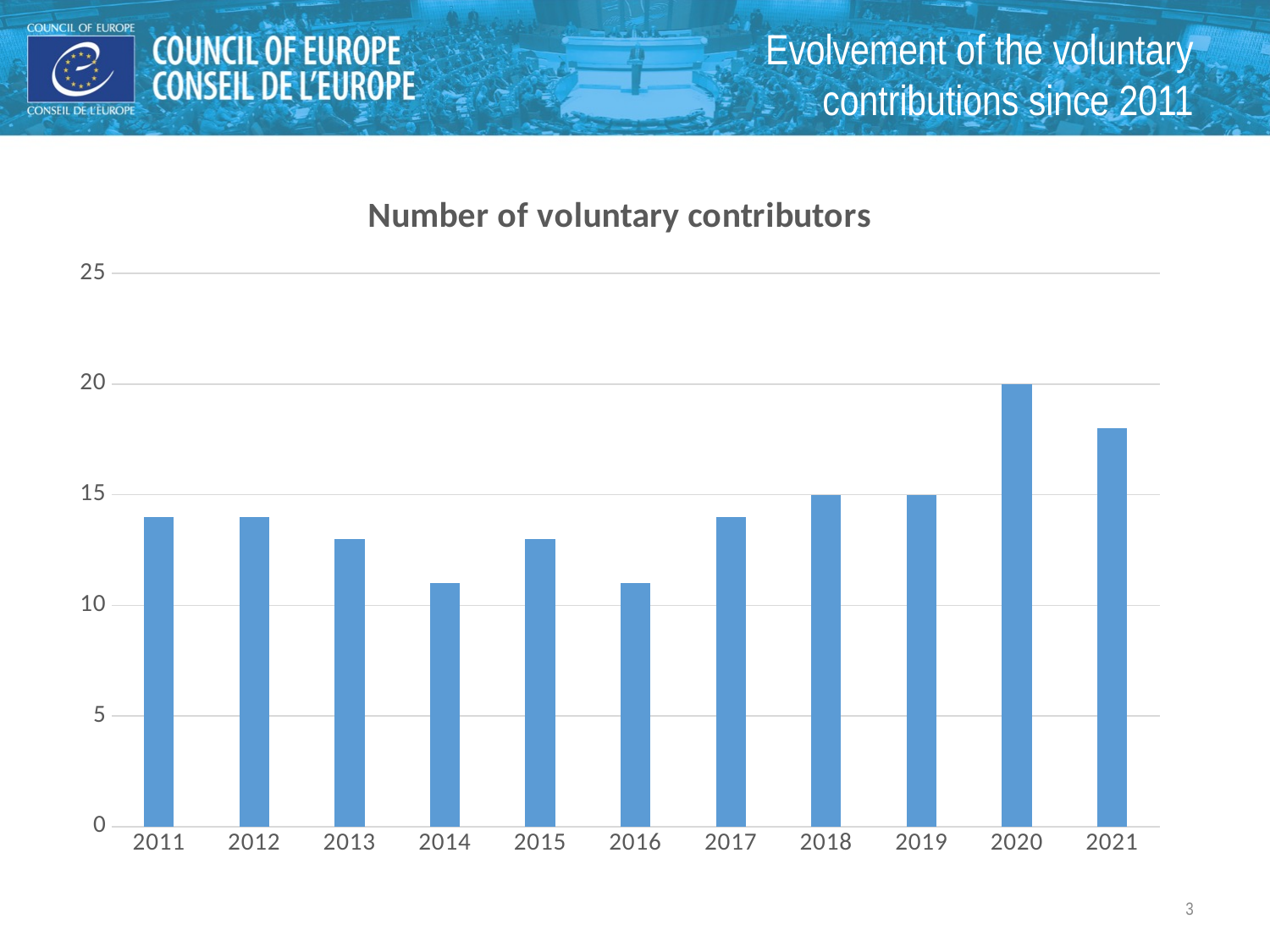
What is the number of voluntary contributors in 2019? 15 Do the values rise or fall from 2017 to 2020? rise Is the value for 2021 greater or less than 15? greater Which year has the highest number of voluntary contributors? 2020 What type of chart is shown on the slide? bar chart Is the value for 2014 greater or less than 15? less What is the number of voluntary contributors in 2020? 20 What is the title of the chart? Number of voluntary contributors What is the number of voluntary contributors in 2018? 15 How many years are shown on the x axis of the chart? 11 Which year has more voluntary contributors, 2020 or 2021? 2020 What is the difference between the number of voluntary contributors in 2020 and in 2018? 5